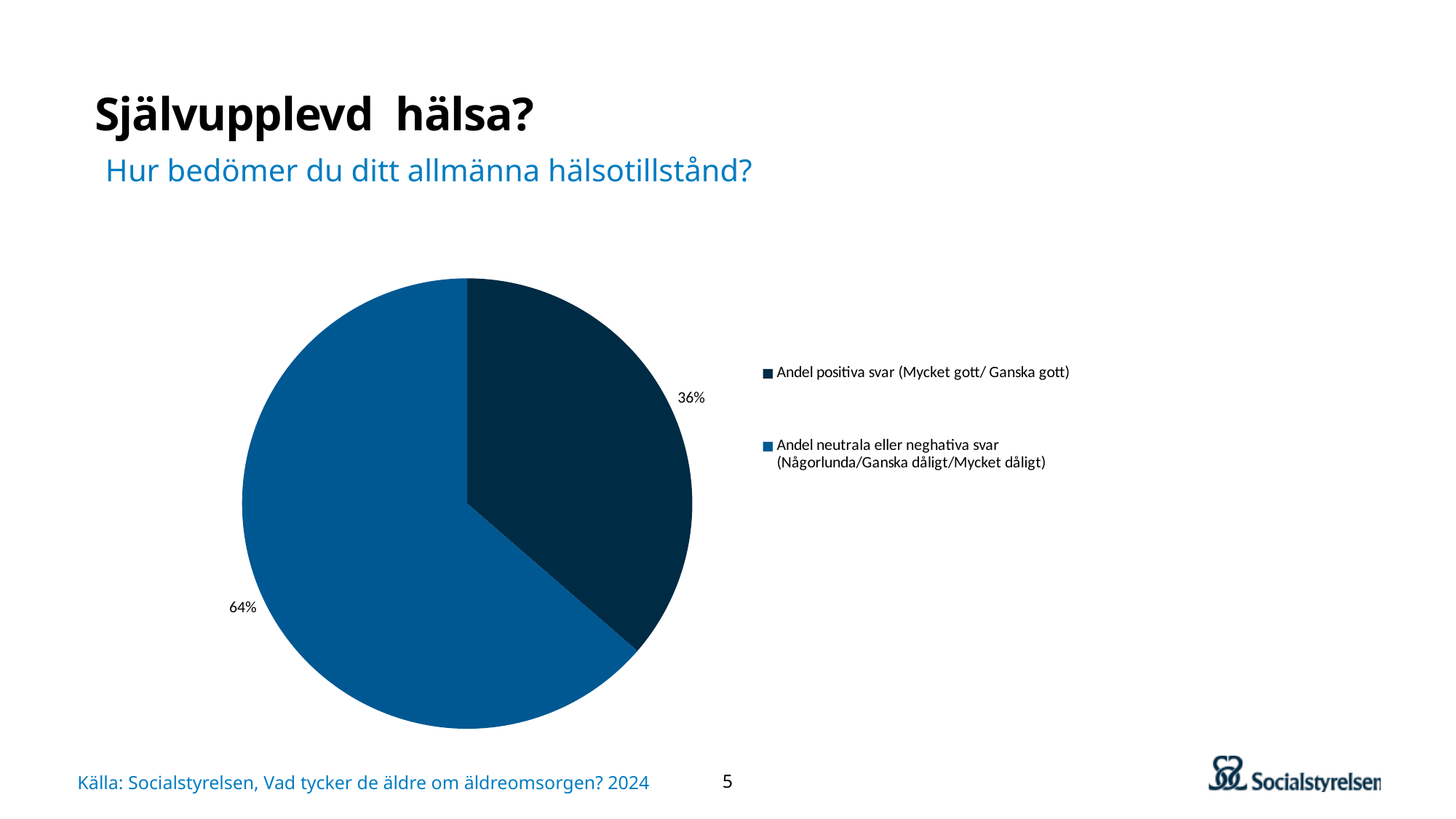
How many slices does the pie chart have? 2 How many entries does the legend list? 2 What question is shown as the subtitle above the chart? Hur bedömer du ditt allmänna hälsotillstånd? What share of the pie is labelled "Andel positiva svar (Mycket gott/ Ganska gott)"? 36% Which slice of the pie is the smallest? Andel positiva svar (Mycket gott/ Ganska gott) What is the difference in percentage points between the neutral/negative slice and the positive slice? 28 What kind of chart is shown on the slide? pie chart Which slice of the pie is the largest? Andel neutrala eller neghativa svar (Någorlunda/Ganska dåligt/Mycket dåligt) Which is larger: the share of positive answers or the share of neutral or negative answers? Andel neutrala eller neghativa svar What is the total of the two percentages shown on the pie chart? 100% Which legend entry is shown in the darker navy colour? Andel positiva svar (Mycket gott/ Ganska gott) What share of the pie is labelled "Andel neutrala eller neghativa svar (Någorlunda/Ganska dåligt/Mycket dåligt)"? 64%